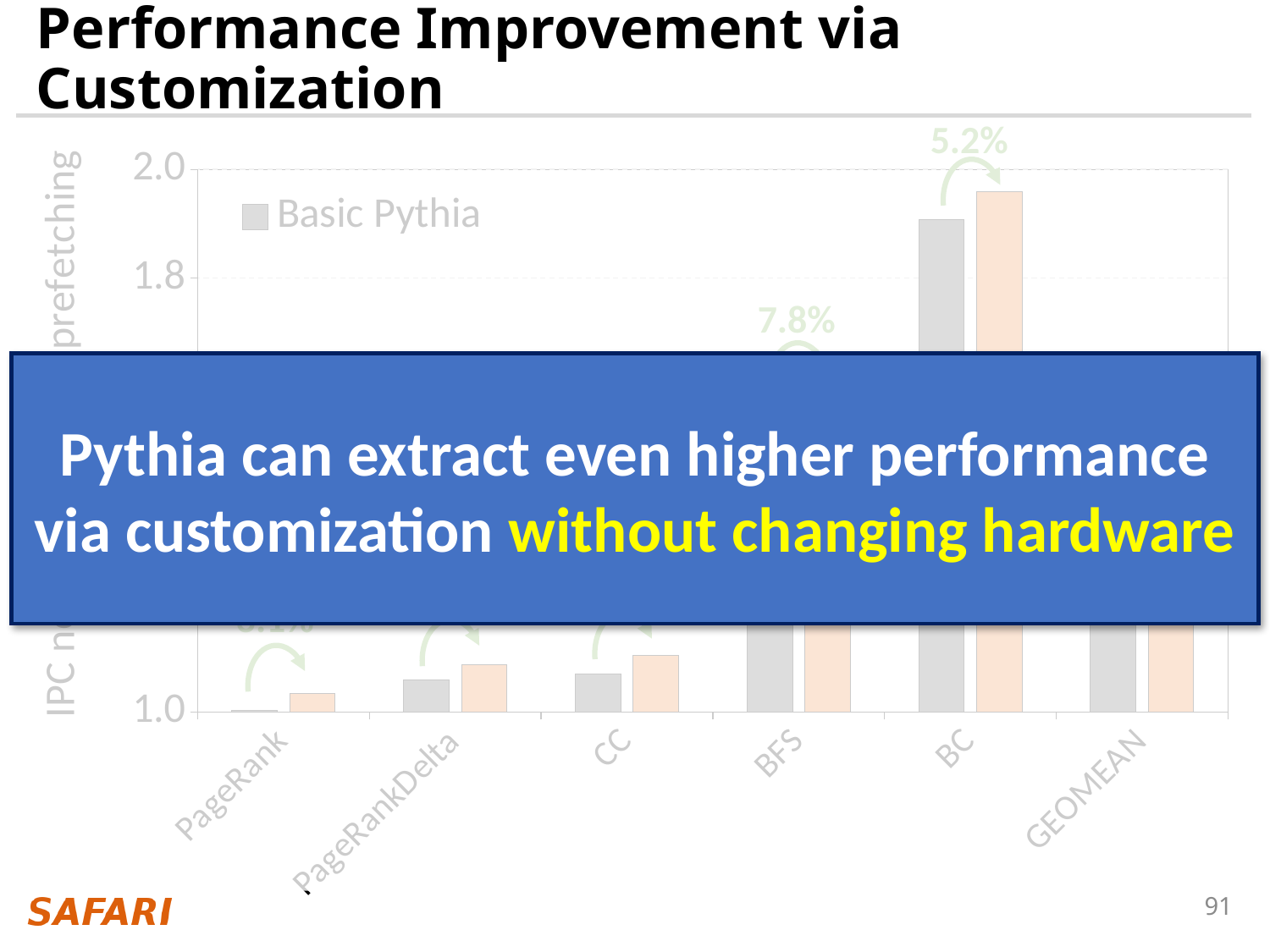
Which has the larger printed percentage improvement, BFS or BC? BFS What kind of chart is shown on the slide? bar chart Which series name is visible in the chart legend? Basic Pythia What is the difference between the percentage labels printed for BFS and BC? 2.6% How many categories are shown on the x axis of the chart? 6 Which category has the shortest bars in the chart? PageRank What percentage label is printed above the BFS bars? 7.8% What percentage label is printed above the BC bars? 5.2% What is the title of the slide containing the chart? Performance Improvement via Customization Is the Basic Pythia value for PageRankDelta greater or less than 1.8? less Which category has the tallest bars in the chart? BC Is the Basic Pythia value for BC greater or less than 1.8? greater